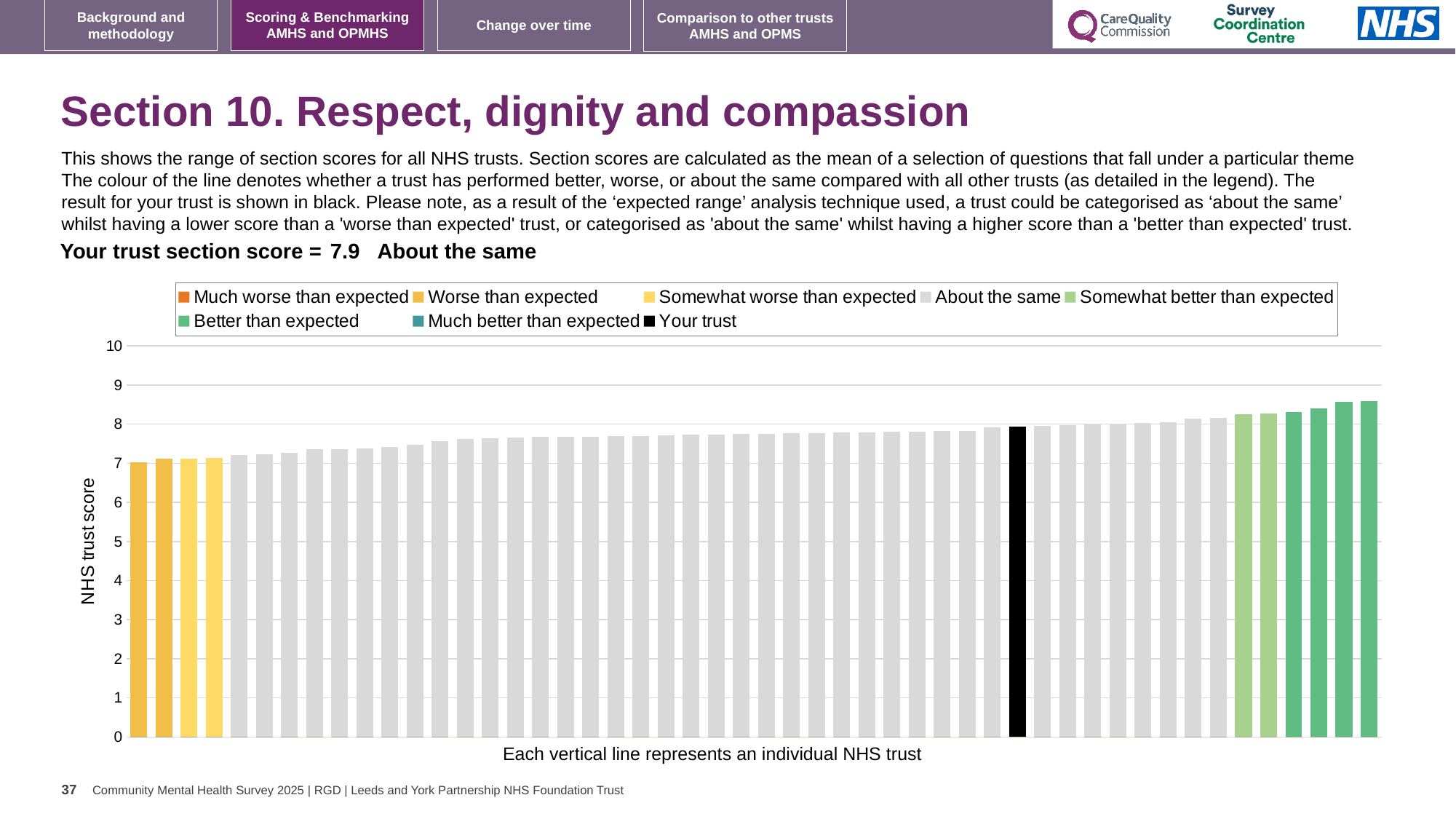
What is the section score for your trust shown on the slide? 7.9 Is the value of the lowest bar greater or less than 8? less Is the value for your trust greater or less than 9? less What kind of chart is shown on the slide? bar chart Do the bar values rise or fall from left to right along the x axis? rise How many entries does the chart legend list? 8 Is the value for your trust greater or less than 7? greater What is the highest value shown on the vertical axis? 10 What is the label on the vertical axis of the chart? NHS trust score Which category is your trust's section score placed in? About the same